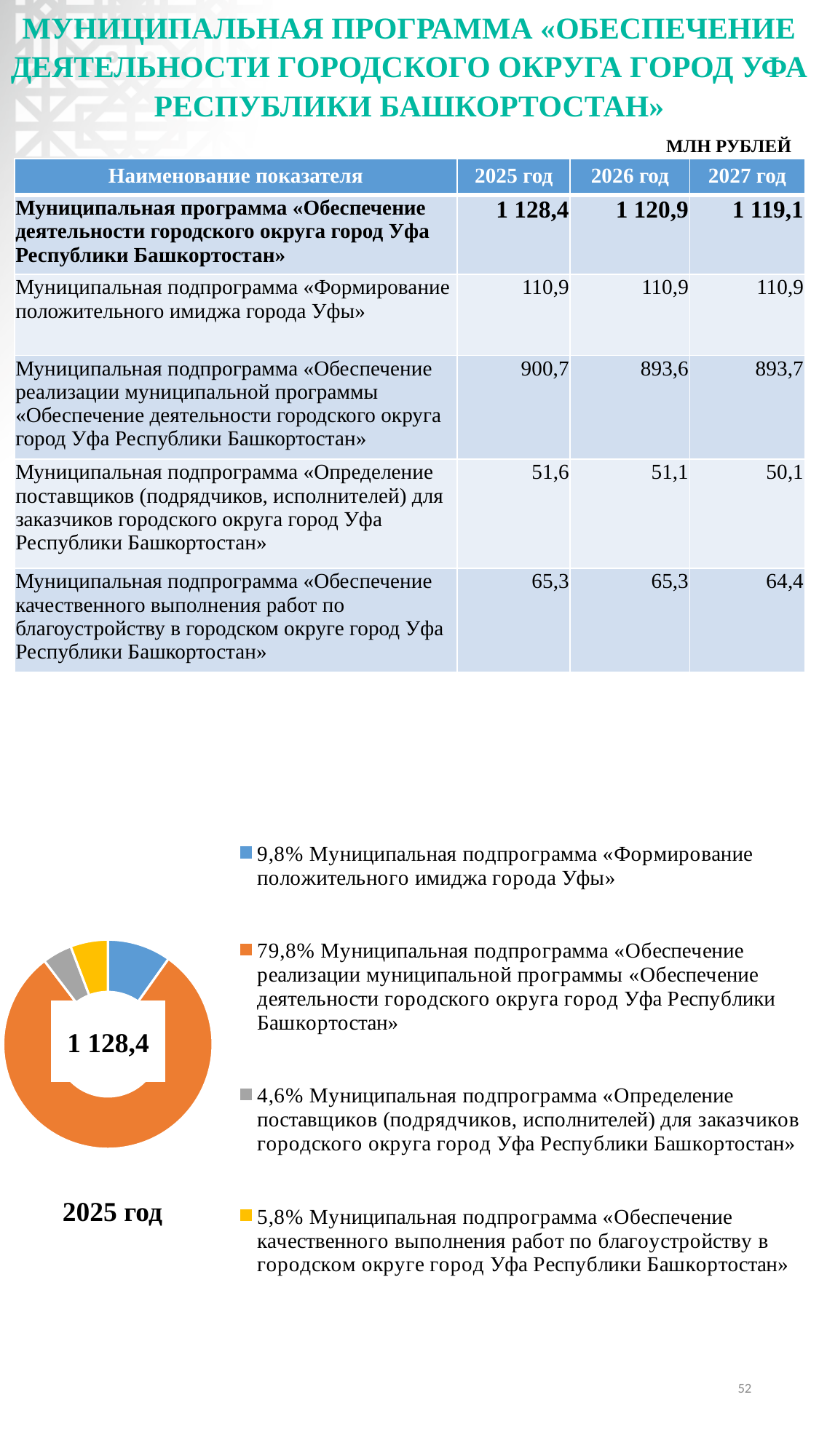
What share of the 2025 год pie chart is the subprogram «Формирование положительного имиджа города Уфы»? 9,8% What share of the 2025 год pie chart is the subprogram «Обеспечение качественного выполнения работ по благоустройству...»? 5,8% What share of the 2025 год pie chart is the subprogram «Обеспечение реализации муниципальной программы...»? 79,8% How many slices does the 2025 год pie chart have? 4 Which subprogram has the largest slice in the 2025 год pie chart? Муниципальная подпрограмма «Обеспечение реализации муниципальной программы «Обеспечение деятельности городского округа город Уфа Республики Башкортостан» What total value is shown in the centre of the 2025 год pie chart? 1 128,4 Which subprogram has the smallest slice in the 2025 год pie chart? Муниципальная подпрограмма «Определение поставщиков (подрядчиков, исполнителей) для заказчиков городского округа город Уфа Республики Башкортостан» What kind of chart is shown on the slide for 2025 год? pie chart (doughnut) In the 2025 год pie chart, which slice is larger: «Формирование положительного имиджа города Уфы» or «Обеспечение качественного выполнения работ по благоустройству...»? «Формирование положительного имиджа города Уфы» What colour is the largest slice in the 2025 год pie chart? orange What is the difference in percentage points between the 79,8% slice and the 9,8% slice in the 2025 год pie chart? 70 percentage points